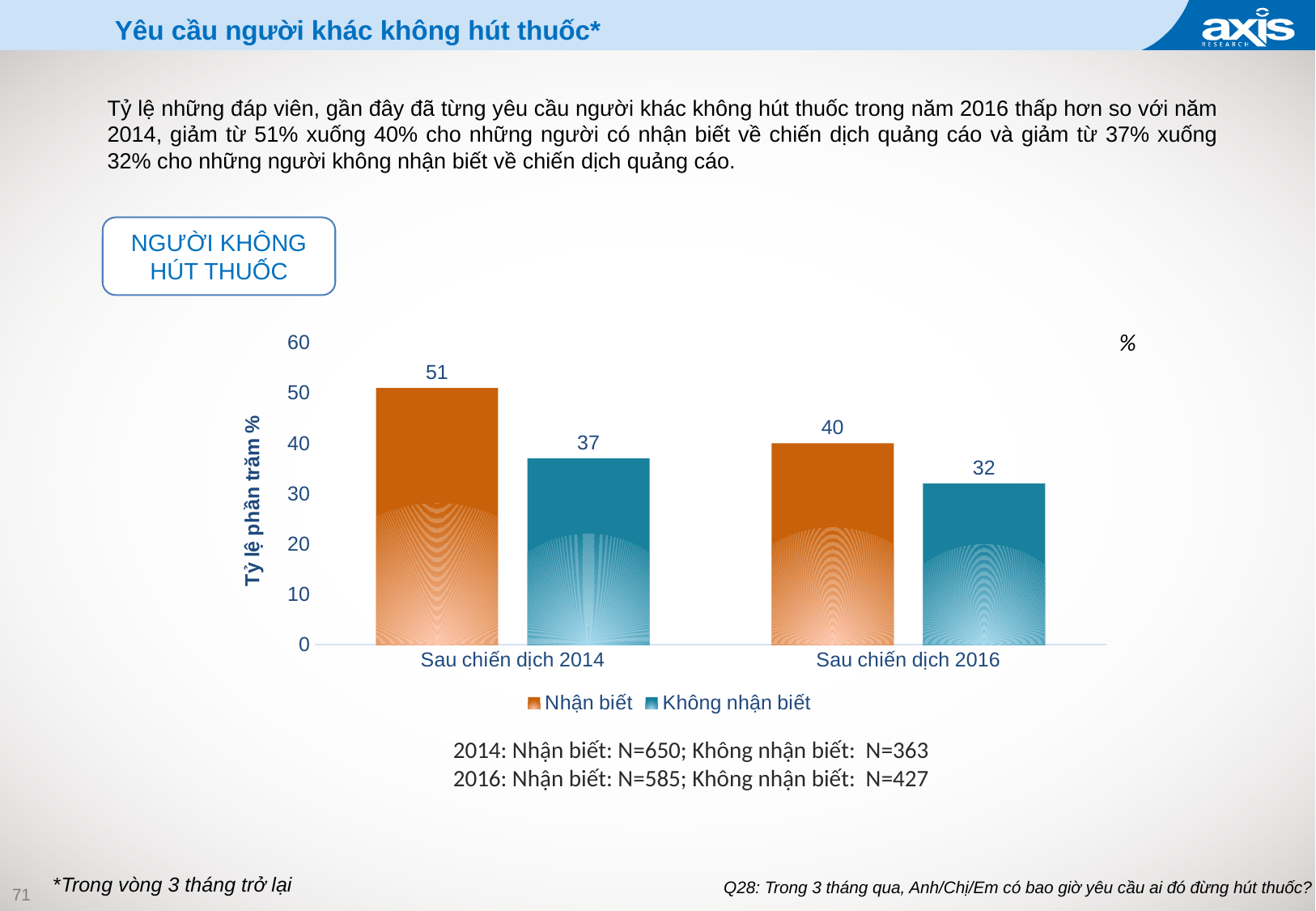
What is the difference between the Nhận biết values for Sau chiến dịch 2014 and Sau chiến dịch 2016? 11 What kind of chart is shown on the slide? Bar chart Which bar has the lowest value on the chart? Không nhận biết, Sau chiến dịch 2016 What is the value for Nhận biết in Sau chiến dịch 2016? 40 Does the Không nhận biết value rise or fall from Sau chiến dịch 2014 to Sau chiến dịch 2016? Fall What is the value for Nhận biết in Sau chiến dịch 2014? 51 How many categories are shown on the x axis? 2 Which bar has the highest value on the chart? Nhận biết, Sau chiến dịch 2014 What is the value for Không nhận biết in Sau chiến dịch 2014? 37 Which is larger in Sau chiến dịch 2016: Nhận biết or Không nhận biết? Nhận biết How many series does the legend list? 2 What is the value for Không nhận biết in Sau chiến dịch 2016? 32